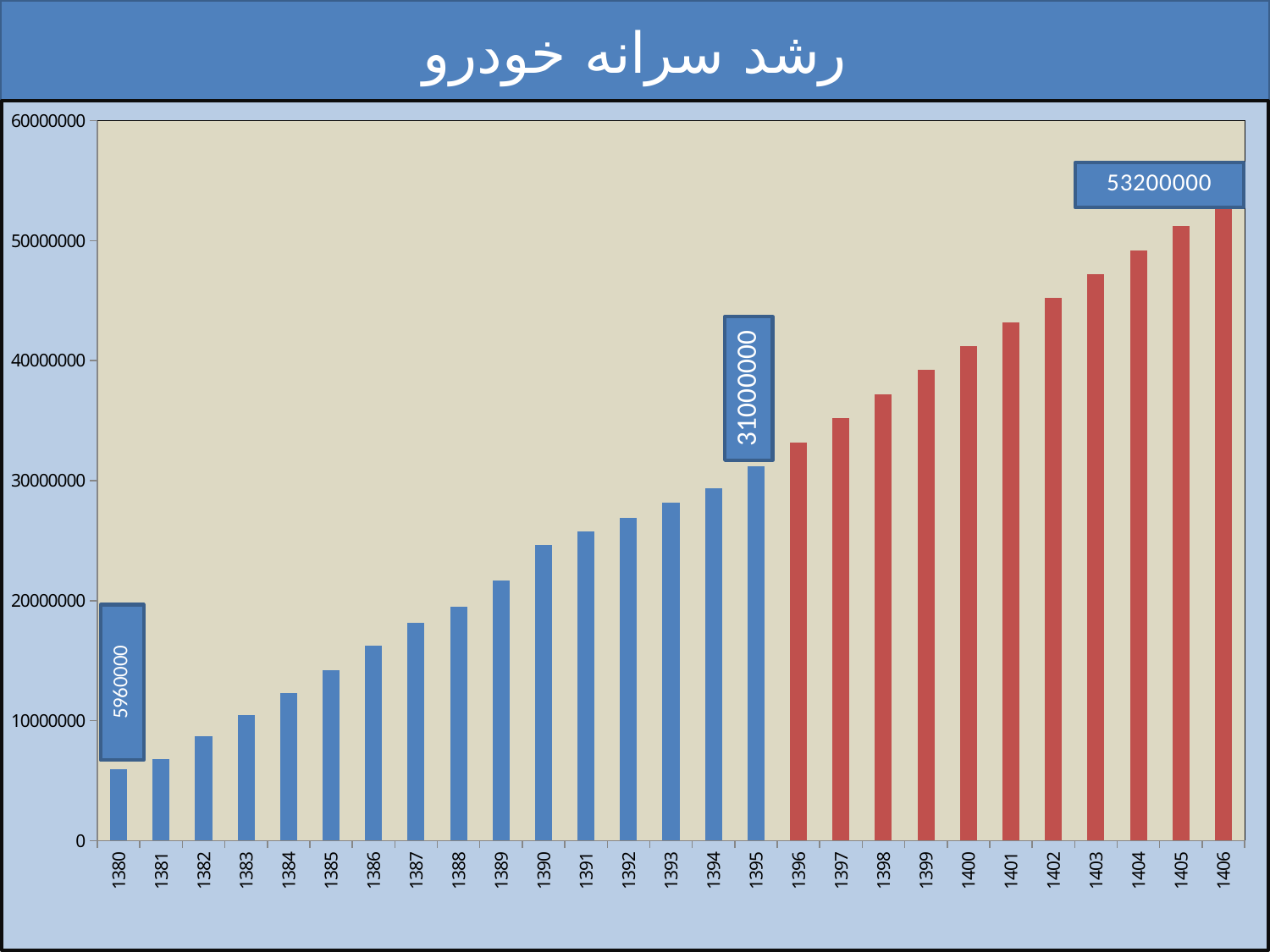
Which year has the highest value? 1406 What is the value for 1380? 5960000 Which year has the lowest value? 1380 Do the values rise or fall from 1380 to 1406? rise Which is larger, the value for 1390 or the value for 1400? 1400 Is the value for 1400 greater or less than 40000000? greater What is the difference between the values for 1395 and 1380? 25040000 What is the value for 1395? 31000000 What is the difference between the values for 1406 and 1395? 22200000 What is the value for 1406? 53200000 How many years are shown on the x axis? 27 What kind of chart is shown on the slide? bar chart